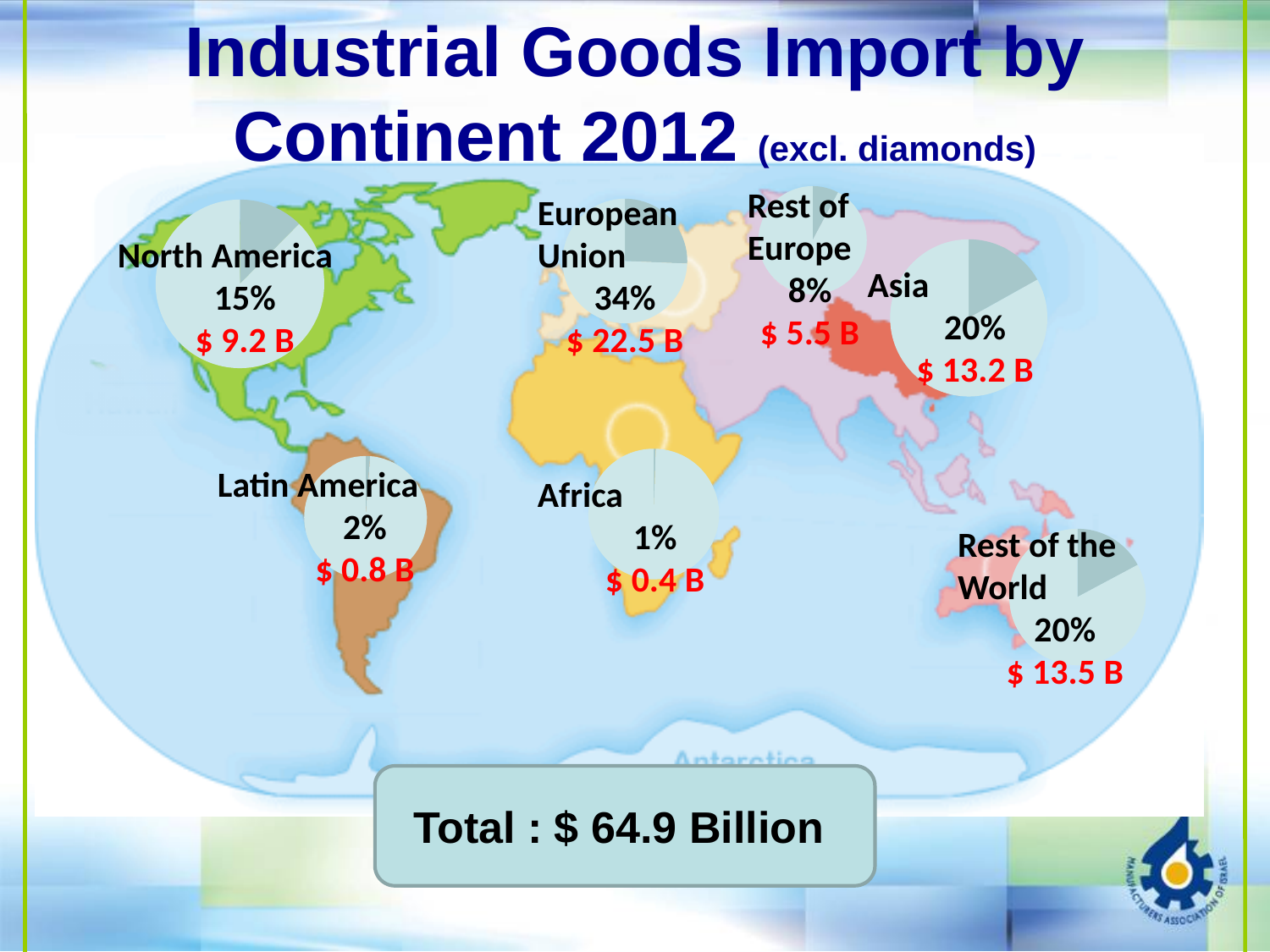
What share of industrial goods imports in 2012 came from the European Union? 34% How much larger, in billions of dollars, were imports from the European Union than from Asia? $ 9.3 B What percentage of imports came from Rest of Europe? 8% What does the slide title say is excluded from the import figures? Diamonds What was the dollar value of industrial goods imports from Asia in 2012? $ 13.2 B Which region accounted for the largest share of industrial goods imports in 2012? European Union Which had a higher import value, Asia or Rest of the World? Rest of the World How many regions are shown with their own pie chart on the map? 7 Which region accounted for the smallest share of industrial goods imports in 2012? Africa What kind of chart is used for each region on the map? Pie chart What was the dollar value of industrial goods imports from North America in 2012? $ 9.2 B What is the total value of industrial goods imports shown on the slide? $ 64.9 Billion